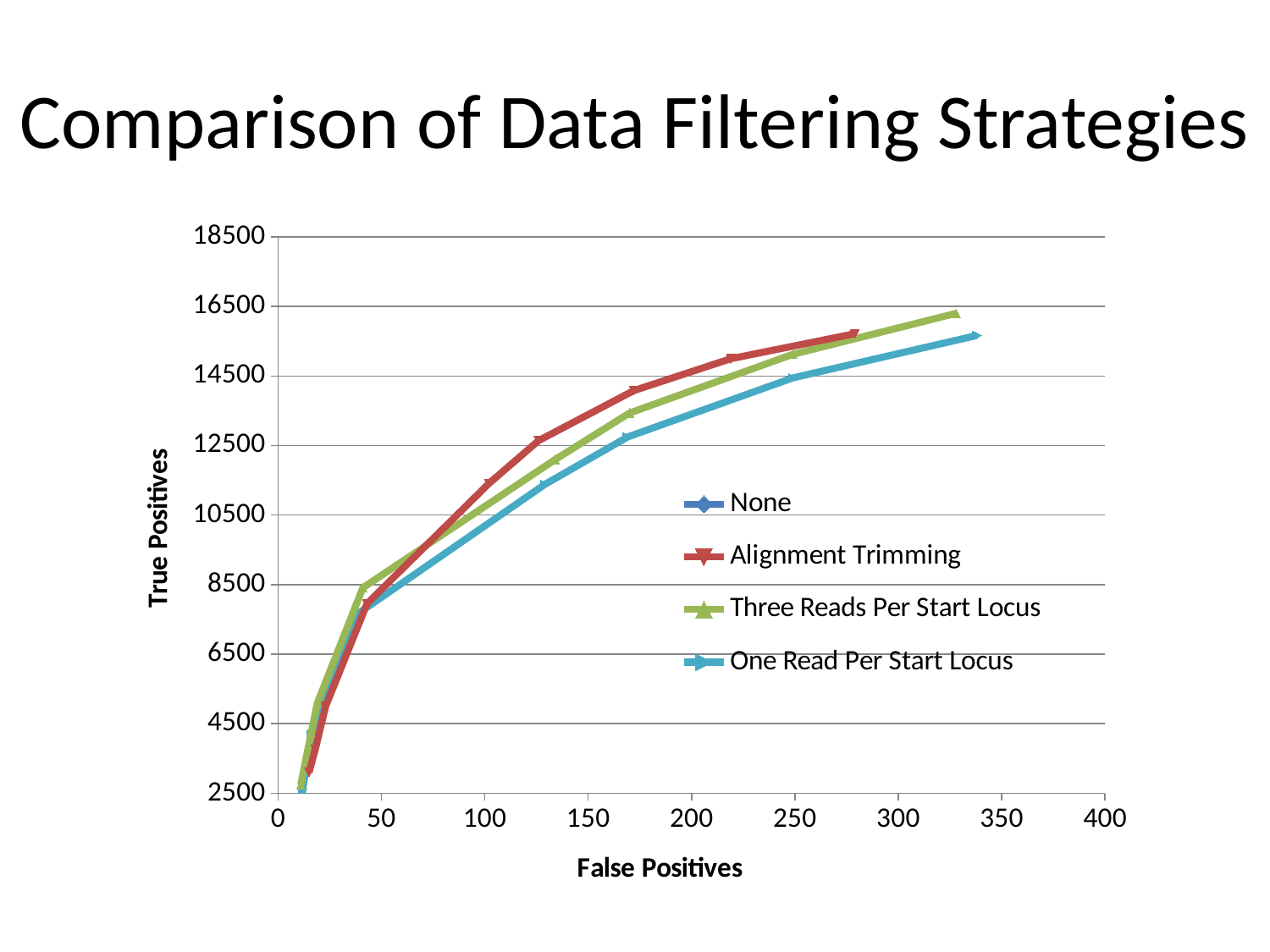
What is the maximum value shown on the False Positives axis? 400 What is the label of the vertical axis? True Positives Is the highest true positives value reached by the Three Reads Per Start Locus series greater or less than 16500? less At around 170 false positives, which series has more true positives: Alignment Trimming or One Read Per Start Locus? Alignment Trimming Which series extends to the largest number of false positives? One Read Per Start Locus Do the true positives rise or fall as false positives increase along the x axis? Rise Is the highest true positives value reached by the One Read Per Start Locus series greater or less than 14500? greater Which series reaches the highest number of true positives? Three Reads Per Start Locus How many series does the legend list? 4 What is the title of the chart? Comparison of Data Filtering Strategies Is the highest true positives value reached by the Alignment Trimming series greater or less than 14500? greater What type of chart is shown on the slide? Line chart